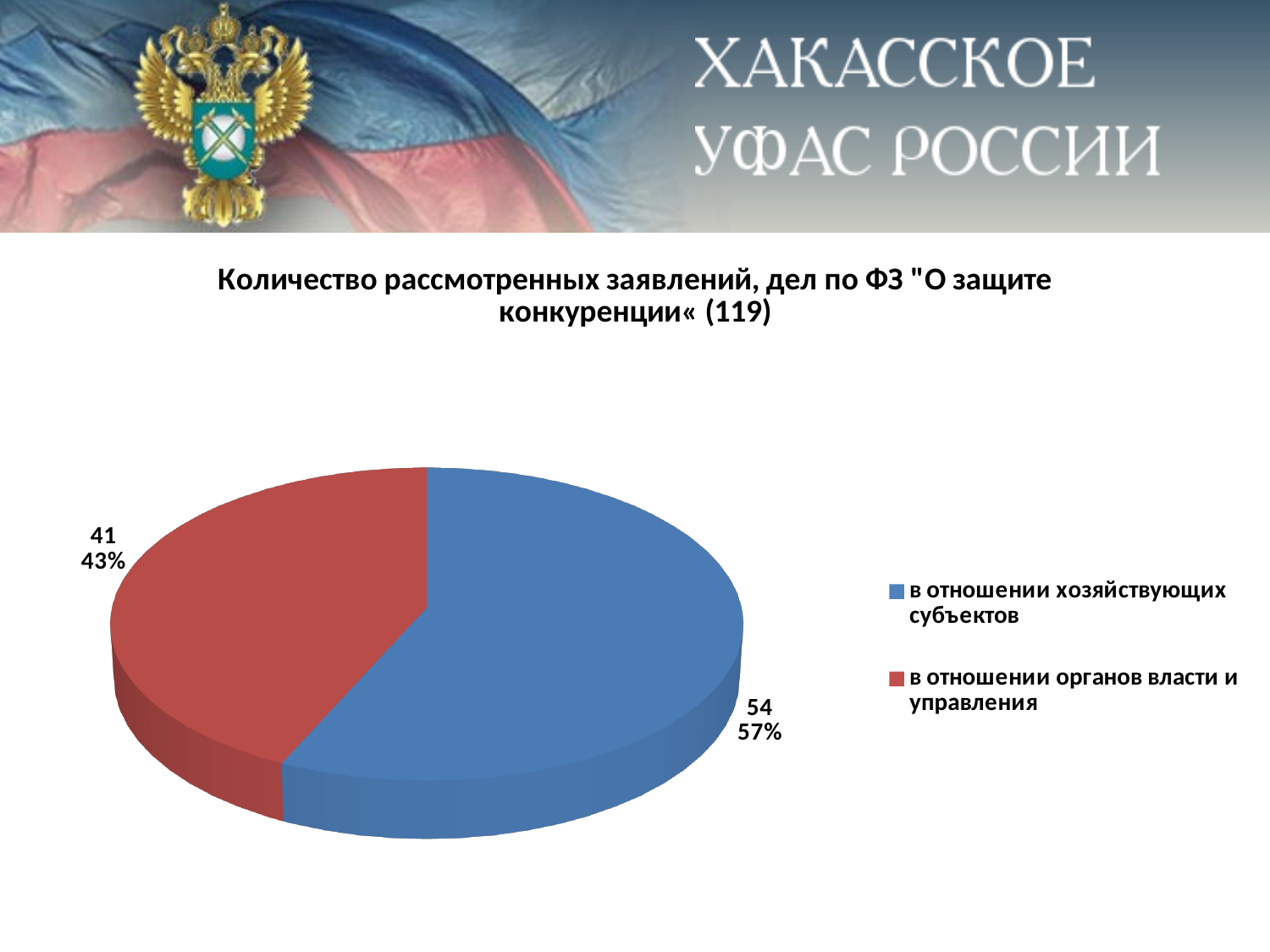
What share of the pie does "в отношении органов власти и управления" represent? 43% What kind of chart is shown on the slide? pie chart What is the difference between the values for "в отношении хозяйствующих субъектов" and "в отношении органов власти и управления"? 13 What is the value for "в отношении хозяйствующих субъектов"? 54 What is the value for "в отношении органов власти и управления"? 41 Which is larger: the value for "в отношении хозяйствующих субъектов" or for "в отношении органов власти и управления"? в отношении хозяйствующих субъектов What share of the pie does "в отношении хозяйствующих субъектов" represent? 57% Which category has the largest slice? в отношении хозяйствующих субъектов How many slices does the pie chart have? 2 What colour is the slice for "в отношении органов власти и управления"? red Which category has the smallest slice? в отношении органов власти и управления What is the total of the two values shown in the pie chart? 95